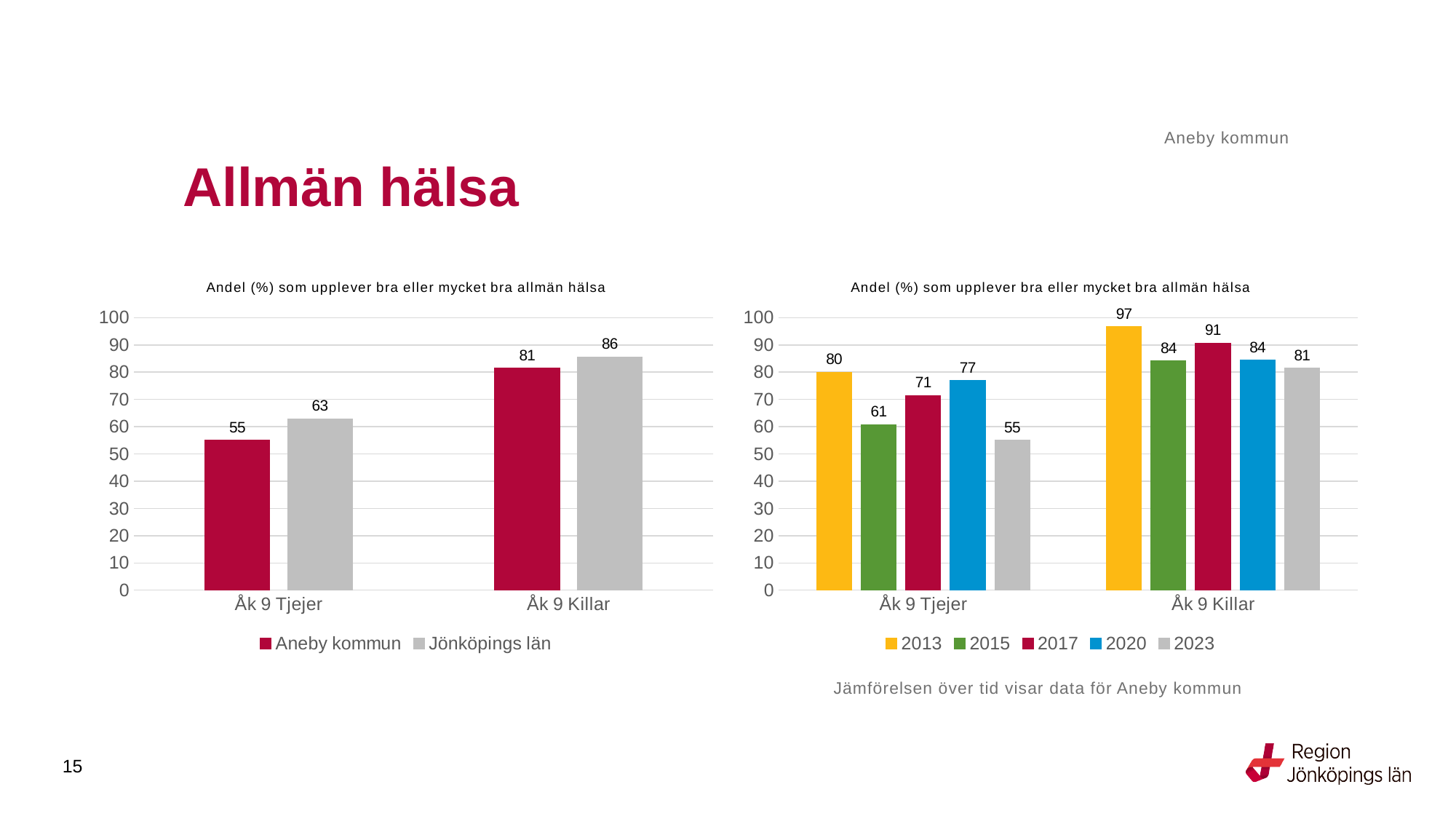
In the right chart, what is the value for 2020 for Åk 9 Tjejer? 77 In the right chart, what is the value for 2013 for Åk 9 Killar? 97 In the left chart, which is larger for Åk 9 Killar: Aneby kommun or Jönköpings län? Jönköpings län In the right chart, which year has the highest value for Åk 9 Killar? 2013 In the right chart, what is the difference between the 2013 and 2023 values for Åk 9 Killar? 16 How many series does the legend of the right chart list? 5 In the left chart, what is the value for Jönköpings län for Åk 9 Killar? 86 In the left chart, what is the value for Aneby kommun for Åk 9 Tjejer? 55 In the left chart, what is the difference between Jönköpings län and Aneby kommun for Åk 9 Tjejer? 8 How many series does the legend of the left chart list? 2 What kind of chart is the left chart? Bar chart In the right chart, which year has the lowest value for Åk 9 Tjejer? 2023